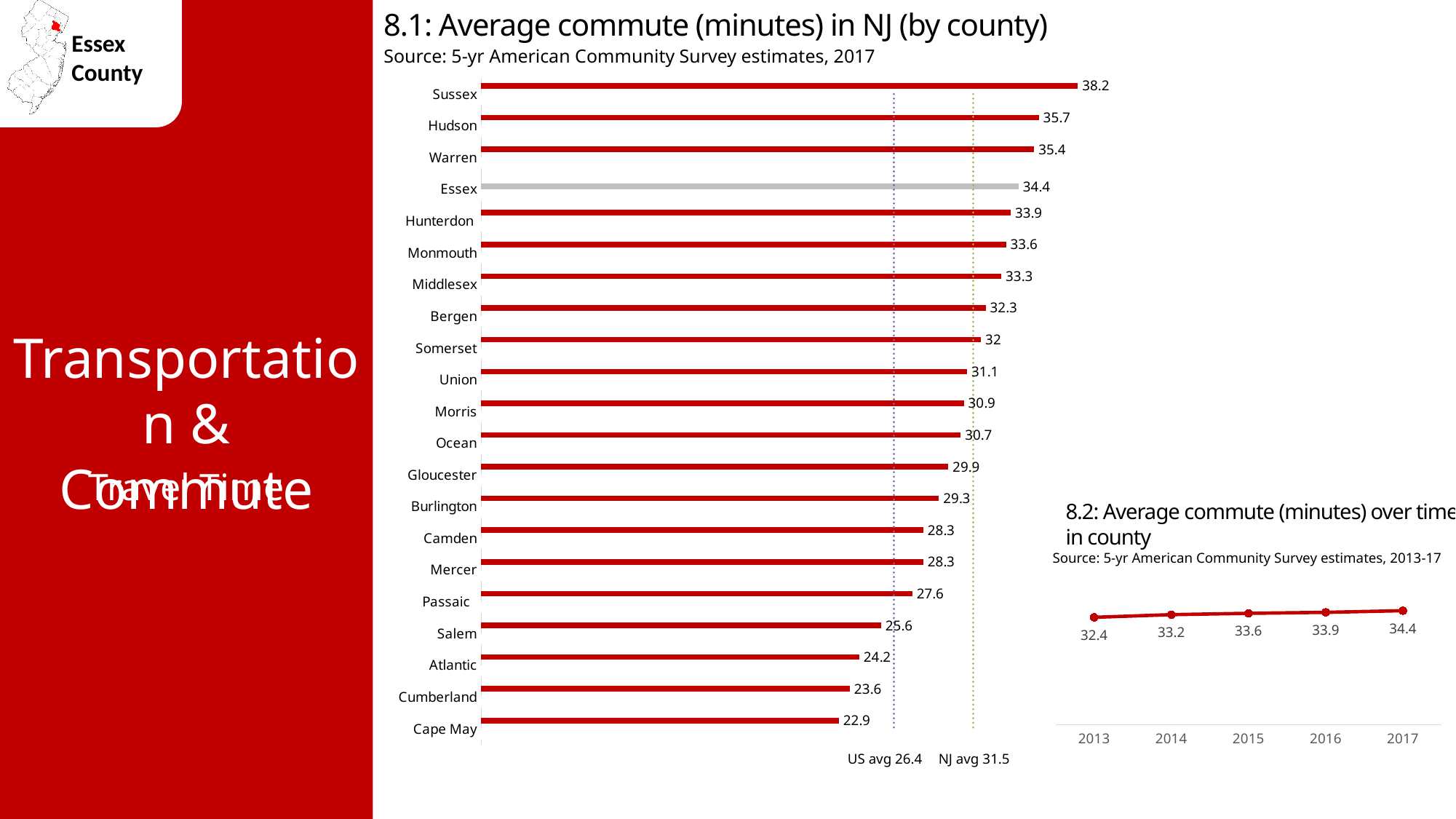
In chart 8.2 (Average commute over time in county), do the values rise or fall from 2013 to 2017? Rise What kind of chart is chart 8.1 (Average commute in NJ by county)? Bar chart In chart 8.1 (Average commute in NJ by county), what is the average commute for Essex? 34.4 In chart 8.2 (Average commute over time in county), what is the value for 2013? 32.4 In chart 8.1 (Average commute in NJ by county), how many counties are shown? 21 In chart 8.1 (Average commute in NJ by county), what is the difference between Sussex and Cape May? 15.3 In chart 8.1 (Average commute in NJ by county), which is larger, the value for Bergen or the value for Somerset? Bergen In chart 8.1 (Average commute in NJ by county), what NJ average is shown? 31.5 In chart 8.1 (Average commute in NJ by county), which county has the highest average commute? Sussex In chart 8.2 (Average commute over time in county), how many years are plotted? 5 In chart 8.1 (Average commute in NJ by county), what is the average commute for Hudson? 35.7 In chart 8.1 (Average commute in NJ by county), which county has the lowest average commute? Cape May